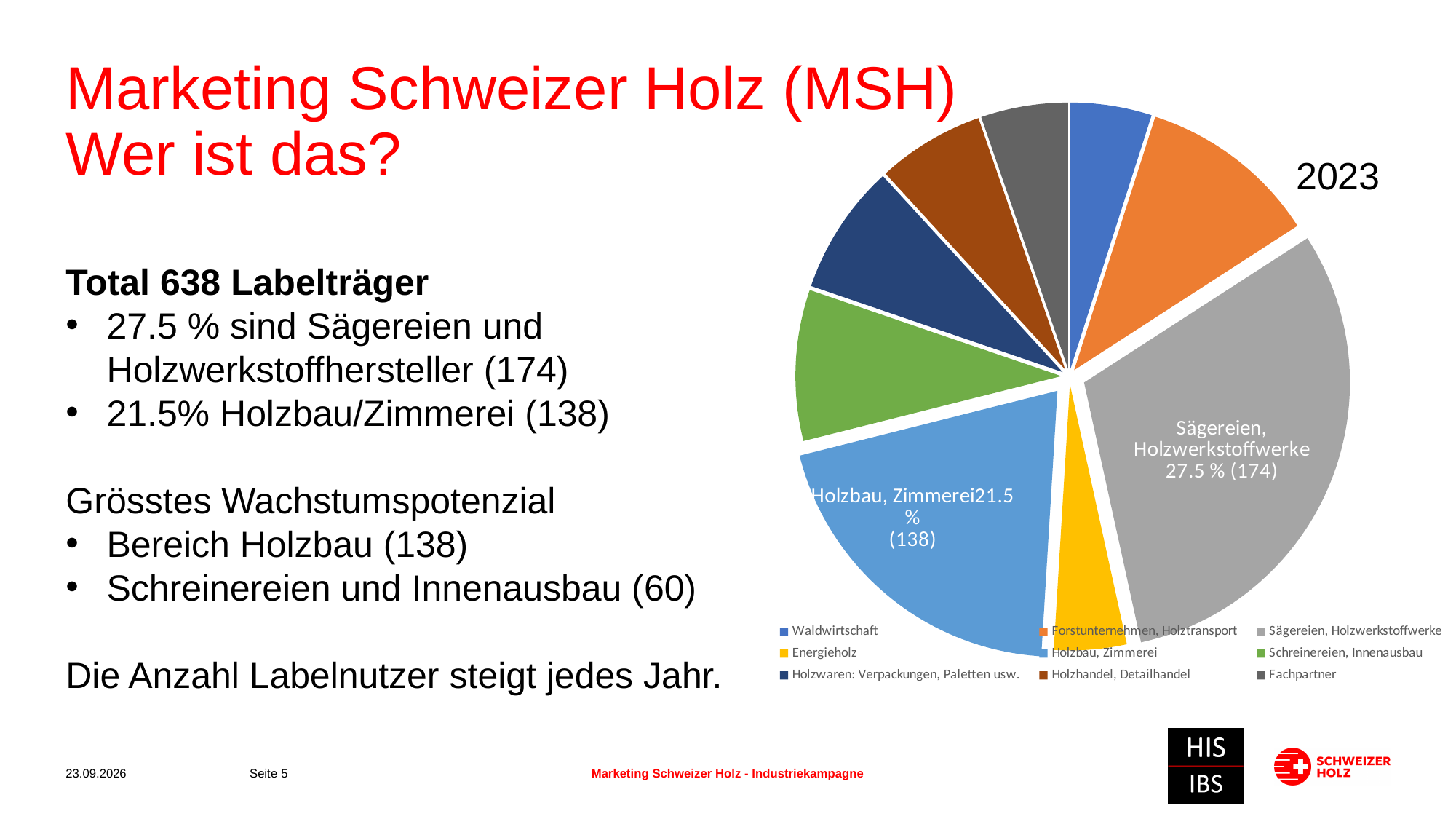
What share of the pie does the Holzbau, Zimmerei slice represent? 21.5 % How many categories does the legend of the pie chart list? 9 What colour is the Sägereien, Holzwerkstoffwerke slice in the pie chart? grey What is the difference in count between the Sägereien, Holzwerkstoffwerke slice and the Holzbau, Zimmerei slice? 36 Which slice is larger: Schreinereien, Innenausbau or Energieholz? Schreinereien, Innenausbau Which category has the largest slice in the pie chart? Sägereien, Holzwerkstoffwerke What kind of chart is shown on the slide? pie chart Which slice is larger: Forstunternehmen, Holztransport or Fachpartner? Forstunternehmen, Holztransport Which year is shown next to the pie chart? 2023 What share of the pie does the Sägereien, Holzwerkstoffwerke slice represent? 27.5 % How many label holders are in the Sägereien, Holzwerkstoffwerke slice of the pie chart? 174 How many label holders are in the Holzbau, Zimmerei slice of the pie chart? 138